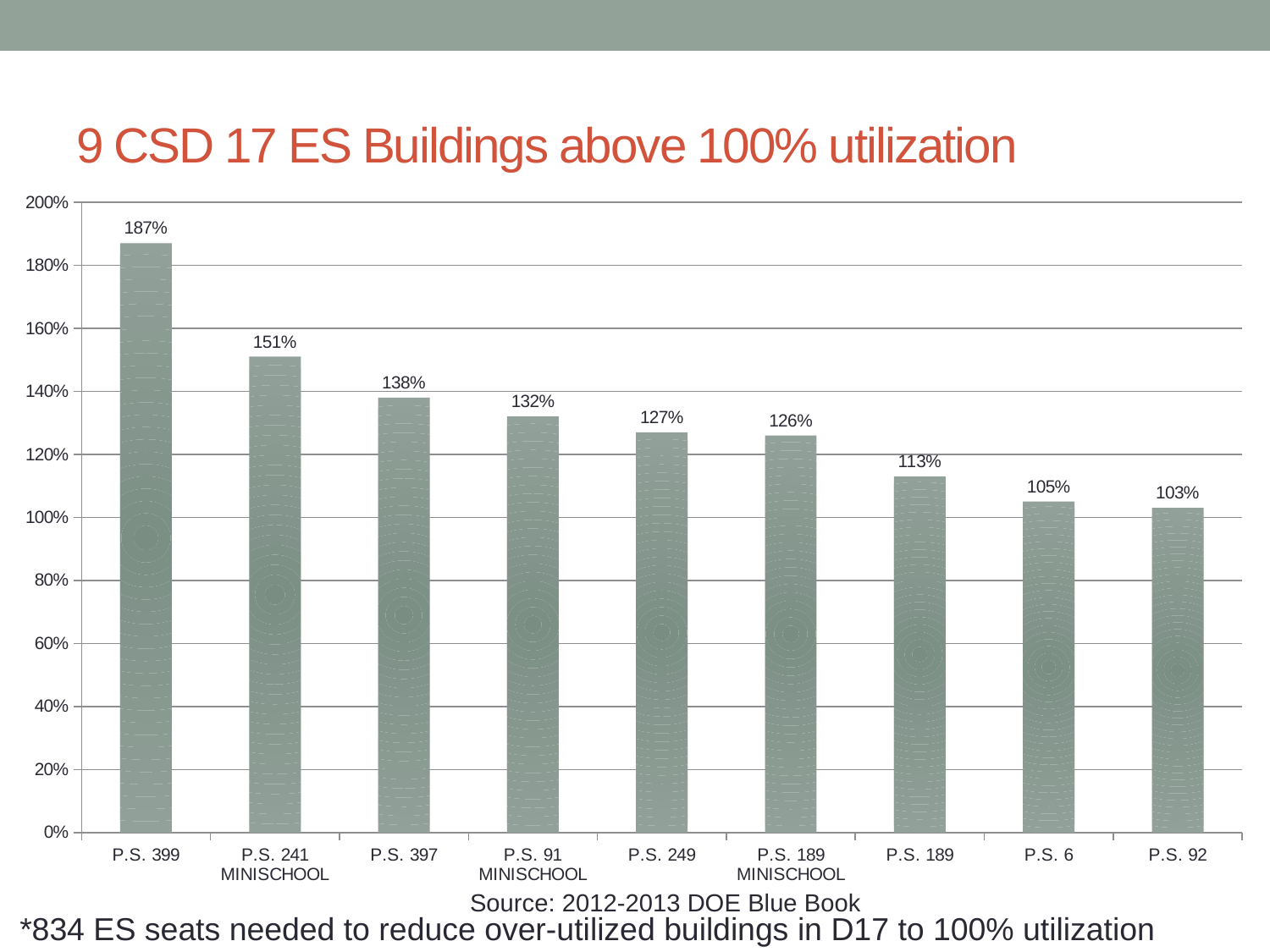
What is the title of the chart? 9 CSD 17 ES Buildings above 100% utilization Do the values rise or fall from left to right across the chart? Fall What is the utilization value for P.S. 249? 127% Which has a higher utilization, P.S. 91 MINISCHOOL or P.S. 6? P.S. 91 MINISCHOOL What is the utilization value for P.S. 399? 187% What is the utilization value for P.S. 92? 103% Which building has the highest utilization? P.S. 399 What kind of chart is shown on the slide? Bar chart How many buildings are shown in the chart? 9 What is the utilization value for P.S. 241 MINISCHOOL? 151% Which building has the lowest utilization? P.S. 92 What is the difference in utilization between P.S. 399 and P.S. 397? 49%